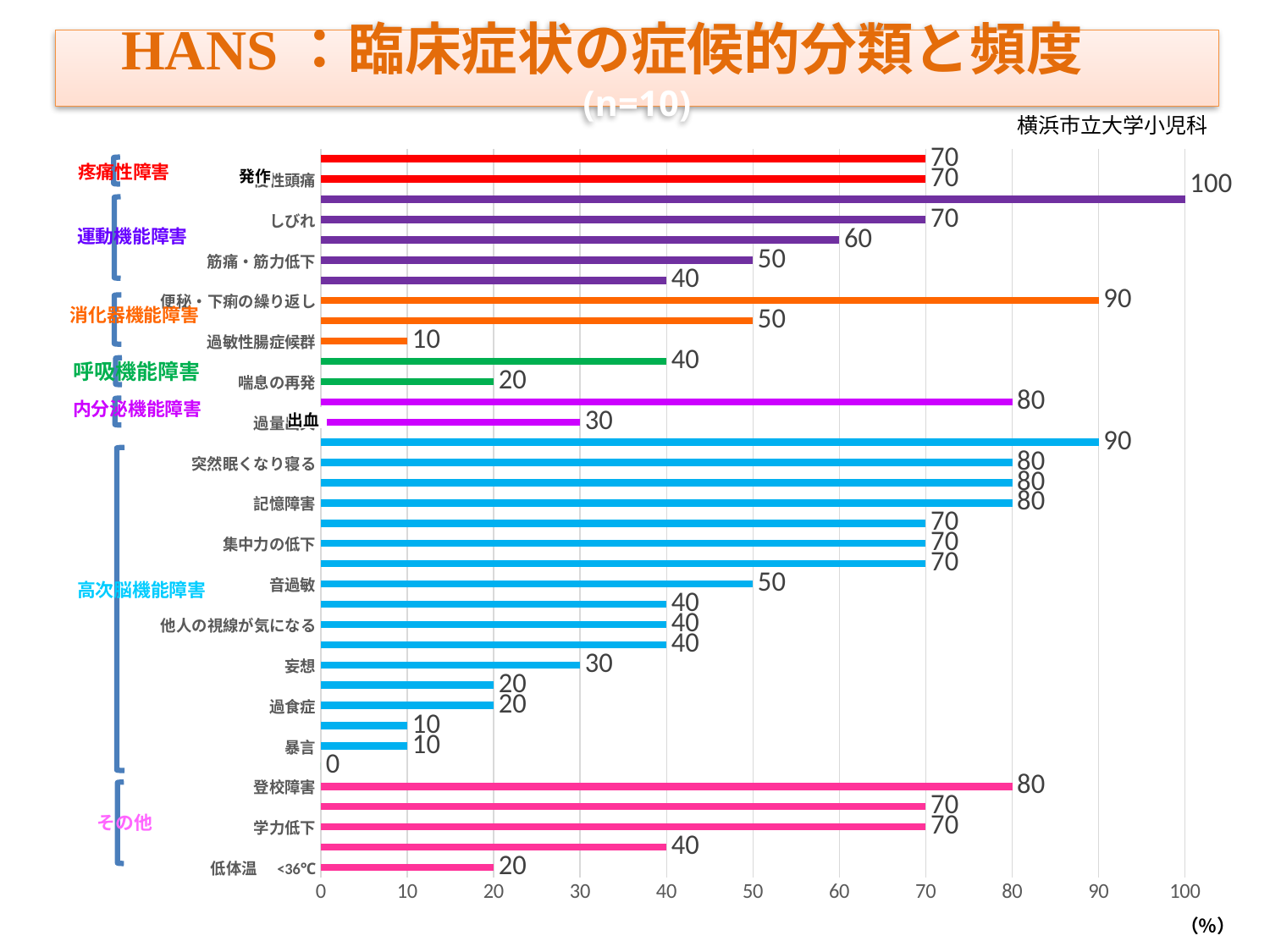
What is the value for 喘息の再発? 20 What is the difference between the values for 便秘・下痢の繰り返し and 過敏性腸症候群? 80 What kind of chart is shown on the slide? bar chart What is the value for 発作性頭痛? 70 What is the value for 過敏性腸症候群? 10 What sample size (n) is stated under the chart title? n=10 What is the value for 便秘・下痢の繰り返し? 90 What is the value for 登校障害? 80 How many symptom groups are labelled along the left side of the chart? 7 What is the lowest value shown on the chart? 0 What is the highest value shown on the chart? 100 Which has the larger value, 登校障害 or 学力低下? 登校障害